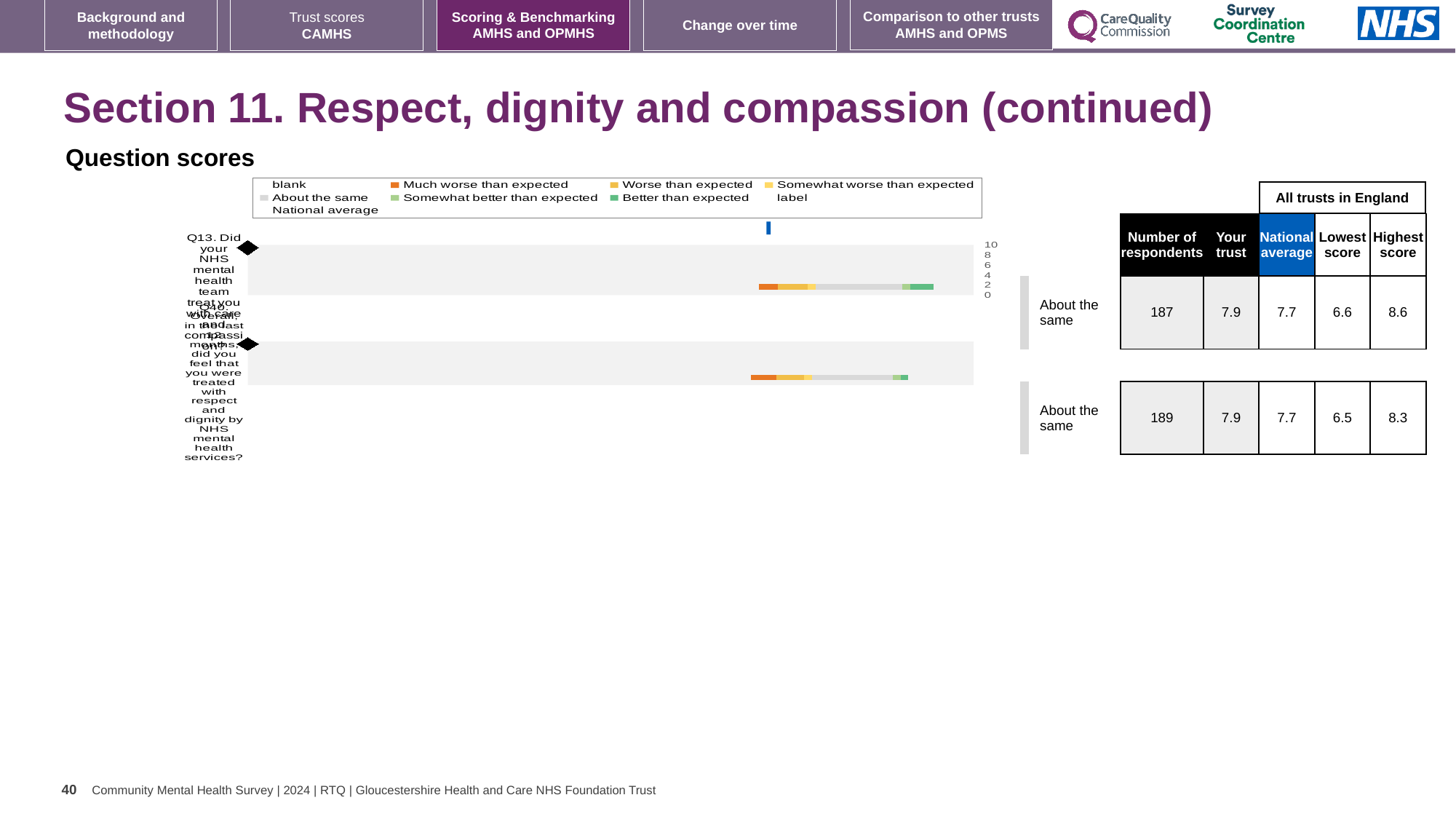
In the table next to the chart, what is the national average for the bottom row? 7.7 What benchmark category label is shown beside both bars in the chart? About the same For the top row, what is the difference between the highest score (8.6) and the lowest score (6.6)? 2.0 In the table next to the chart, what is the lowest score for the bottom row? 6.5 In the table next to the chart, what is the number of respondents for the top row? 187 In the table next to the chart, what is the 'Your trust' score for the top row? 7.9 For the top row, which is larger: the 'Your trust' score or the national average? Your trust How many entries does the chart legend list? 9 What kind of chart is shown under the 'Question scores' heading? bar chart What heading spans the National average, Lowest score and Highest score columns of the table? All trusts in England How many question rows are plotted in the chart? 2 In the table next to the chart, what is the highest score for the top row? 8.6